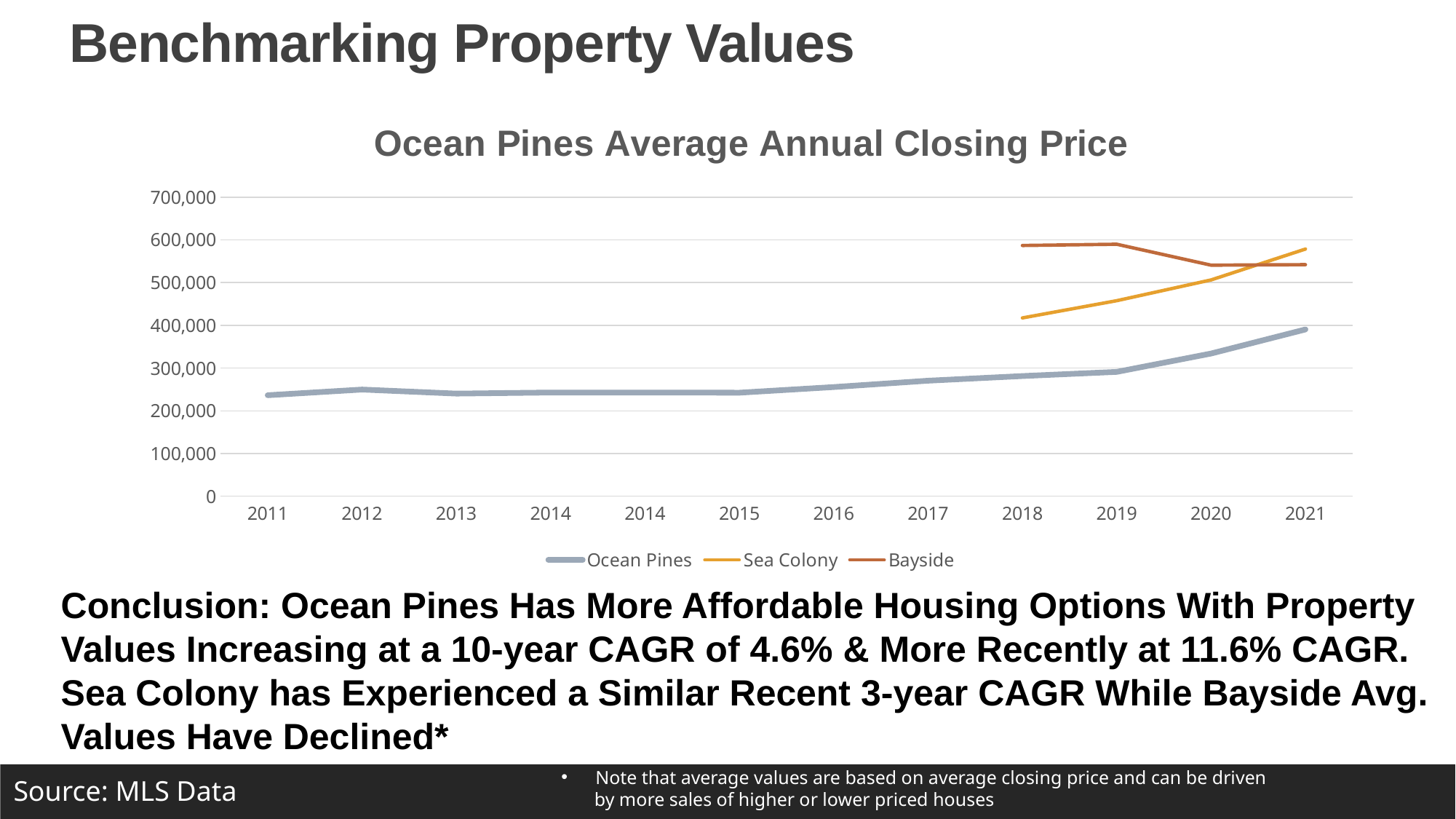
In 2018, which is larger: the Bayside value or the Sea Colony value? Bayside What kind of chart is shown on the slide? Line chart How many year labels are shown on the x axis? 12 Does the Ocean Pines line rise or fall from 2011 to 2021? Rise Which series has the lowest value in 2019? Ocean Pines How many series does the legend list? 3 Which series is drawn in orange/yellow in the legend? Sea Colony What is the title of the chart? Ocean Pines Average Annual Closing Price Is the Ocean Pines value for 2011 greater or less than 200,000? greater Is the Bayside value for 2018 greater or less than 600,000? less Does the Bayside line rise or fall from 2018 to 2021? Fall Is the Sea Colony value for 2018 greater or less than 400,000? greater